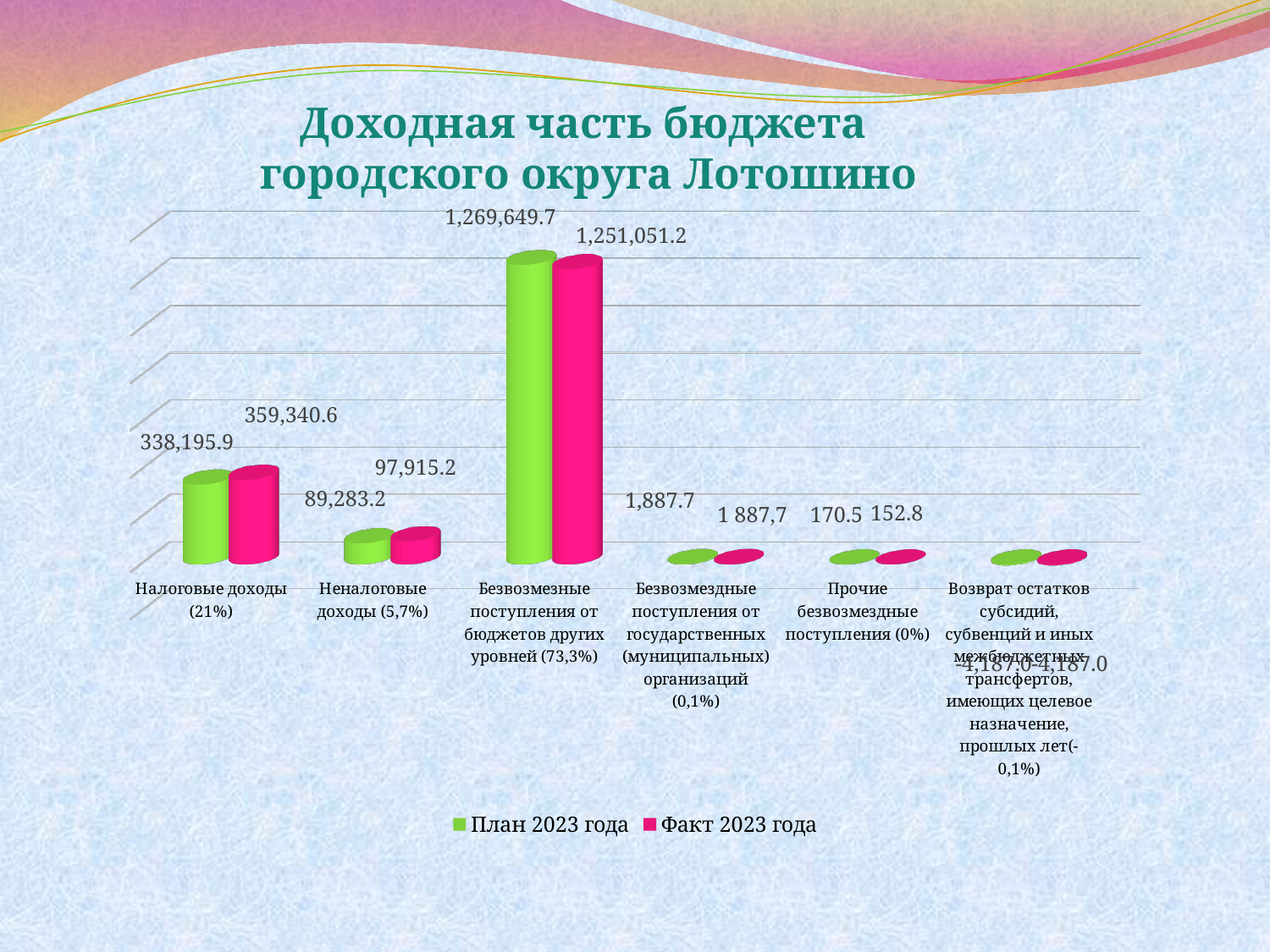
How many series does the legend list? 2 How many categories are shown on the x axis? 6 What is the План 2023 года value for Налоговые доходы (21%)? 338,195.9 What is the difference between the Факт 2023 года and План 2023 года values for Налоговые доходы (21%)? 21,144.7 Which category has the highest План 2023 года value? Безвозмезные поступления от бюджетов других уровней (73,3%) What is the Факт 2023 года value for Налоговые доходы (21%)? 359,340.6 What is the Факт 2023 года value for Неналоговые доходы (5,7%)? 97,915.2 What is the План 2023 года value for Безвозмезные поступления от бюджетов других уровней (73,3%)? 1,269,649.7 What is the Факт 2023 года value for Прочие безвозмездные поступления (0%)? 152.8 Which is larger for Безвозмезные поступления от бюджетов других уровней (73,3%): the План 2023 года value or the Факт 2023 года value? План 2023 года What kind of chart is shown on the slide? Bar chart Which is larger for Неналоговые доходы (5,7%): the План 2023 года value or the Факт 2023 года value? Факт 2023 года